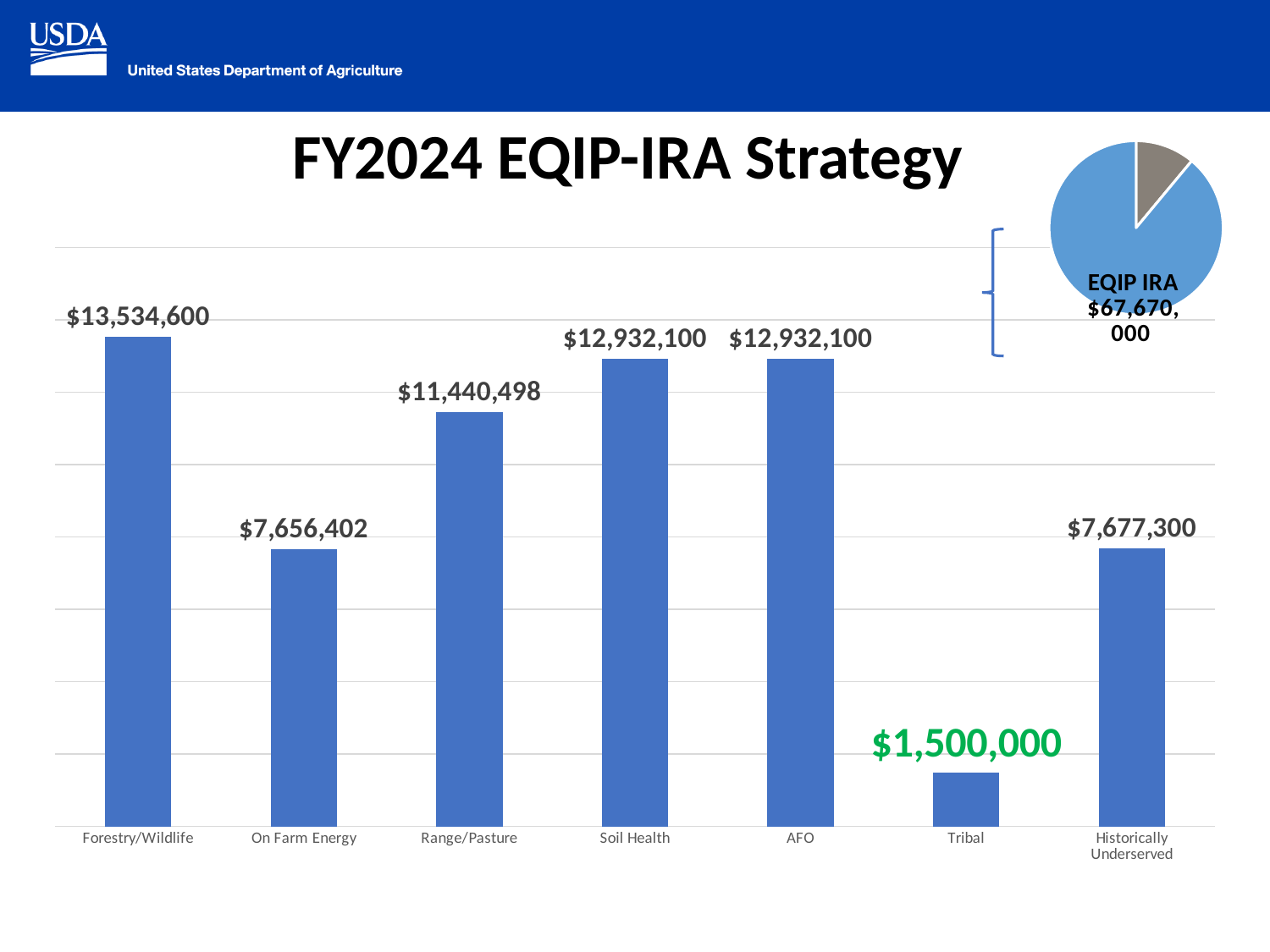
What kind of chart is the large chart on the left of the slide? Bar chart In the bar chart, what is the value for Historically Underserved? $7,677,300 In the bar chart, what is the value for Tribal? $1,500,000 In the bar chart, which category has the lowest value? Tribal In the bar chart, what is the value for Range/Pasture? $11,440,498 What label and value are printed on the pie chart in the top right of the slide? EQIP IRA $67,670,000 How many categories are shown in the bar chart? 7 In the bar chart, which is larger, the value for Range/Pasture or the value for On Farm Energy? Range/Pasture In the bar chart, which category has the highest value? Forestry/Wildlife In the bar chart, what is the difference between the values for Forestry/Wildlife and Soil Health? $602,500 In the bar chart, what is the value for Forestry/Wildlife? $13,534,600 In the bar chart, what is the difference between the values for Historically Underserved and On Farm Energy? $20,898